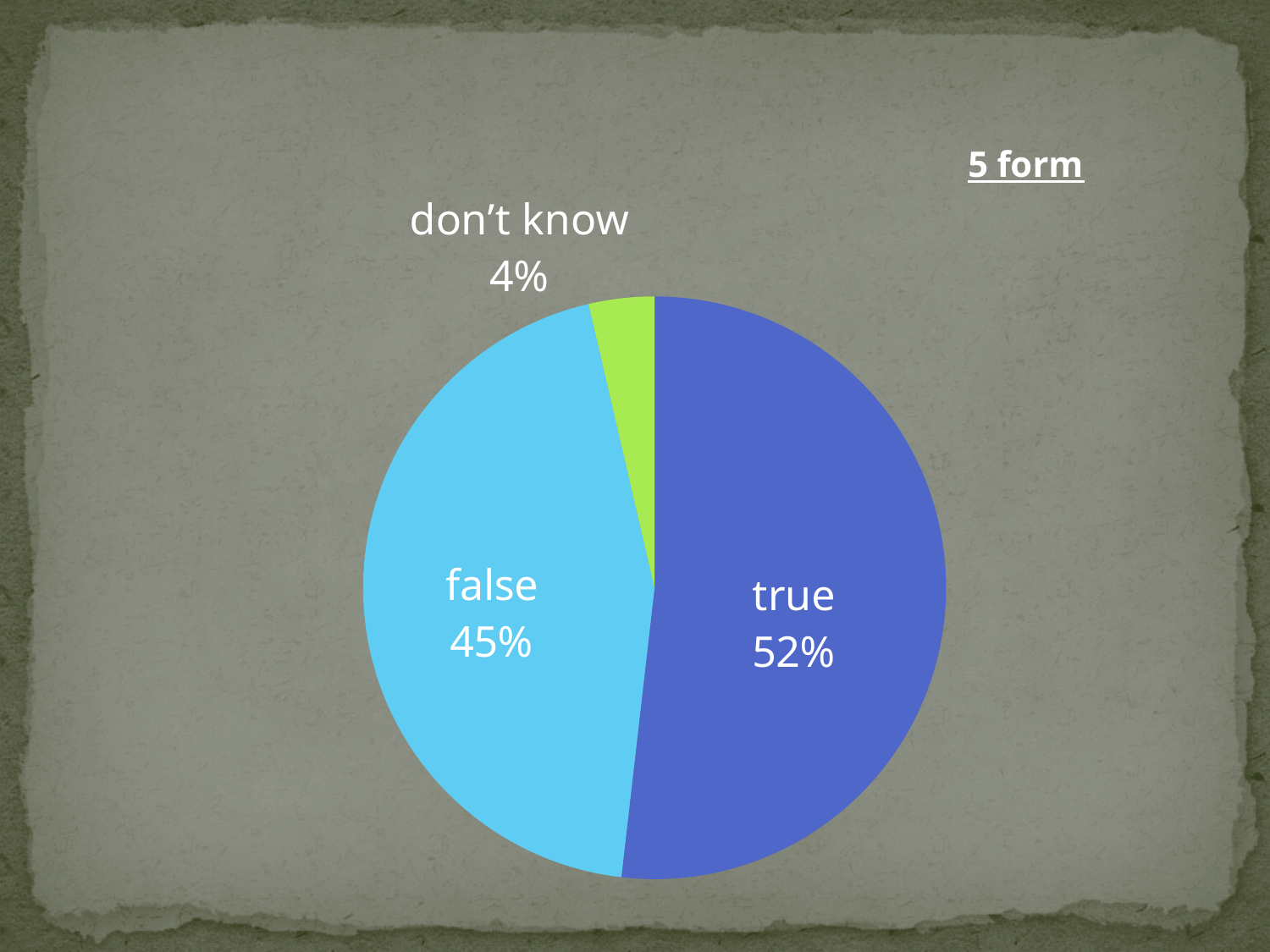
What colour is the "don't know" slice? green What kind of chart is shown on the slide? pie chart What share of the pie does the "true" slice take? 52% Which slice of the pie is the largest? true What percentage of the pie is labelled "true"? 52% How many slices does the pie chart have? 3 What text appears in the top-right corner of the slide above the chart? 5 form Which is larger, the "false" slice or the "don't know" slice? false Which slice of the pie is the smallest? don't know What is the difference in percentage points between the "true" and "false" slices? 7 What percentage of the pie is labelled "false"? 45% What percentage of the pie is labelled "don't know"? 4%